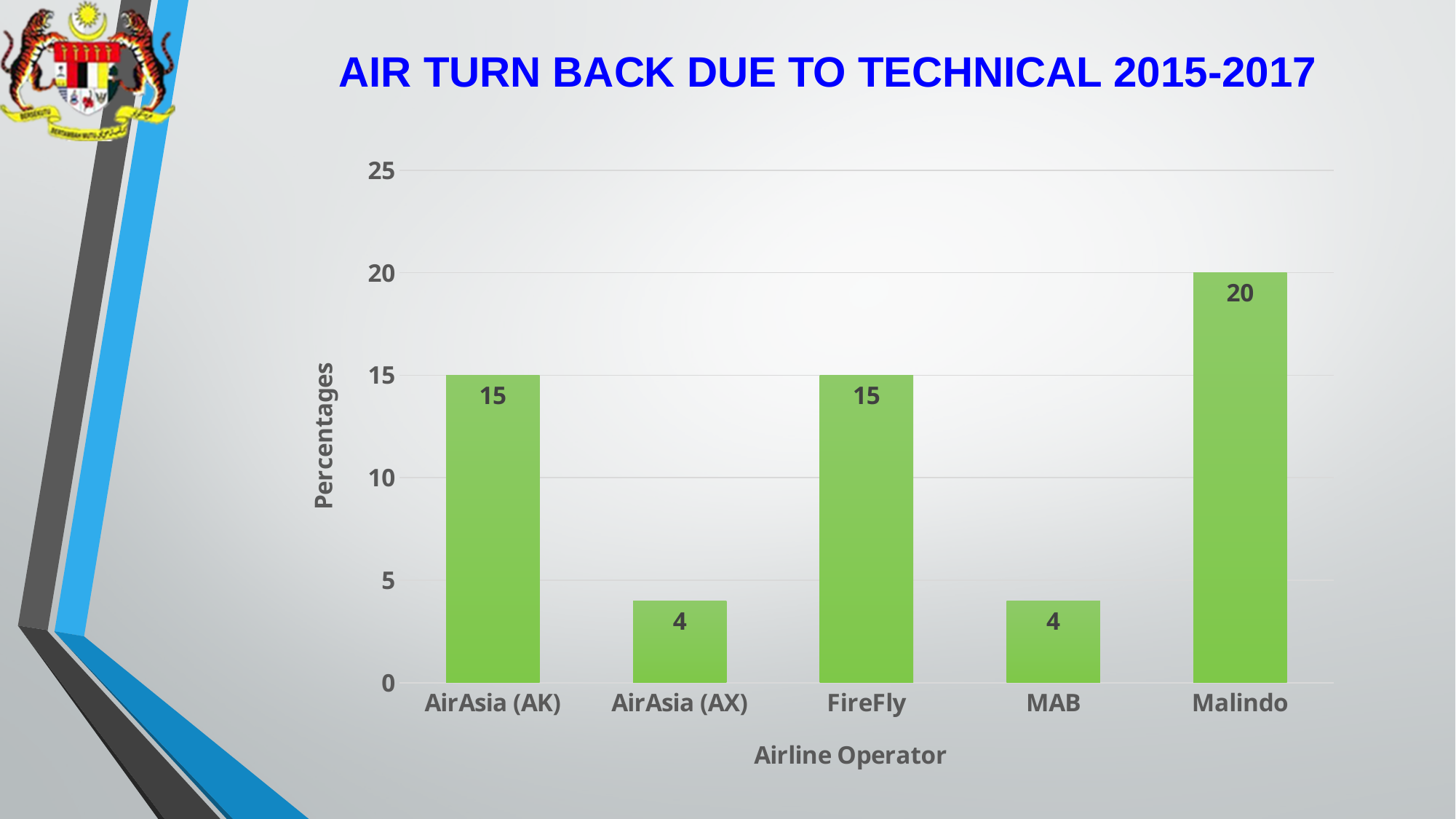
Which airline operator has the highest value? Malindo Which is larger, the value for AirAsia (AK) or the value for AirAsia (AX)? AirAsia (AK) How many airline operators are shown on the chart? 5 What is the value for FireFly? 15 Is the value for Malindo greater or less than 15? greater What is the difference between the values for FireFly and MAB? 11 What is the value for Malindo? 20 What kind of chart is shown on the slide? bar chart What is the difference between the values for Malindo and AirAsia (AK)? 5 What is the value for MAB? 4 What is the value for AirAsia (AX)? 4 What is the title of the chart? AIR TURN BACK DUE TO TECHNICAL 2015-2017